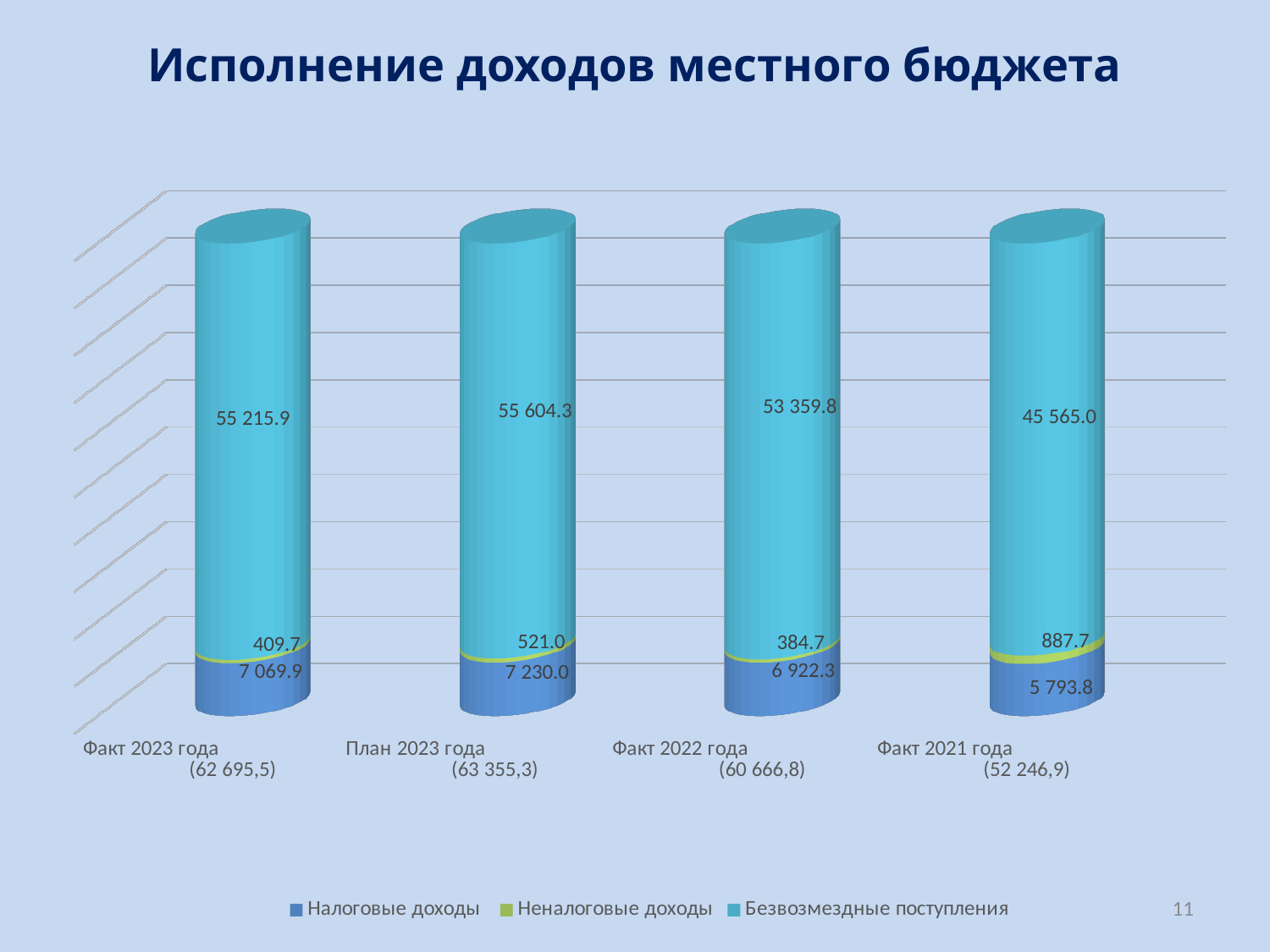
In which category is Безвозмездные поступления the highest? План 2023 года Which is larger: Налоговые доходы for Факт 2023 года or for План 2023 года? План 2023 года What is the value of Неналоговые доходы for Факт 2022 года? 384.7 What is the difference between Безвозмездные поступления for План 2023 года and Факт 2023 года? 388.4 How many categories are shown on the x axis? 4 In which category is Неналоговые доходы the highest? Факт 2021 года In which category is Налоговые доходы the lowest? Факт 2021 года What kind of chart is shown on the slide? Stacked bar chart How many series does the legend list? 3 What is the value of Безвозмездные поступления for Факт 2023 года? 55 215.9 What is the value of Налоговые доходы for План 2023 года? 7 230.0 What is the value of Налоговые доходы for Факт 2021 года? 5 793.8